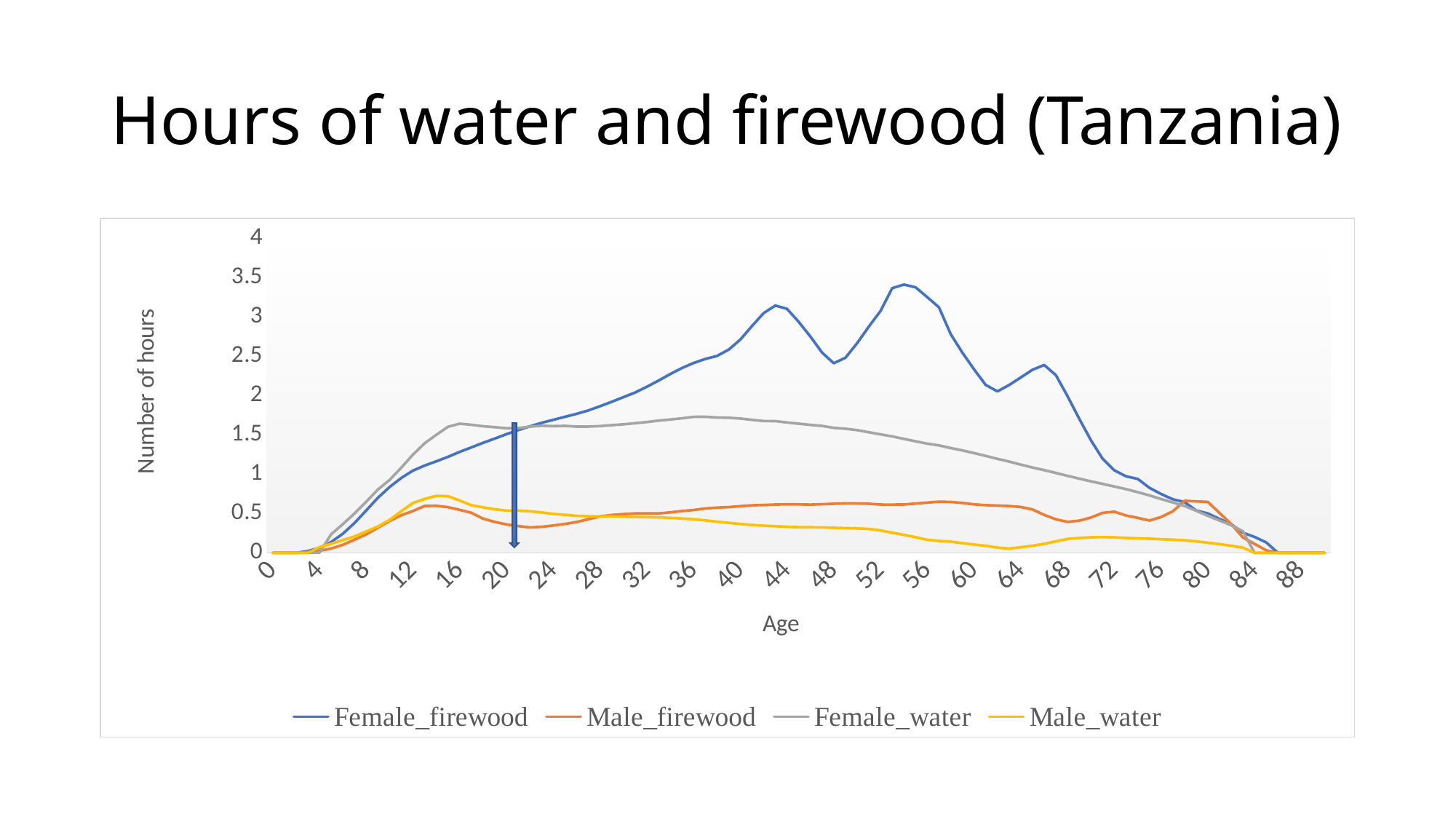
Which series has the lowest value at age 64? Male_water What kind of chart is shown on the slide? line chart Does the Female_water line rise or fall between age 36 and age 84? fall At age 40, which is larger: Female_firewood or Female_water? Female_firewood What is the title of the x axis? Age How many series does the legend list? 4 Is the value for Male_water at age 64 greater or less than 0.5? less Which series reaches the highest number of hours on the chart? Female_firewood Is the value for Female_water at age 16 greater or less than 1? greater At age 60, which is larger: Male_firewood or Male_water? Male_firewood Is the value for Female_firewood at age 54 greater or less than 3? greater What is the title of the y axis? Number of hours